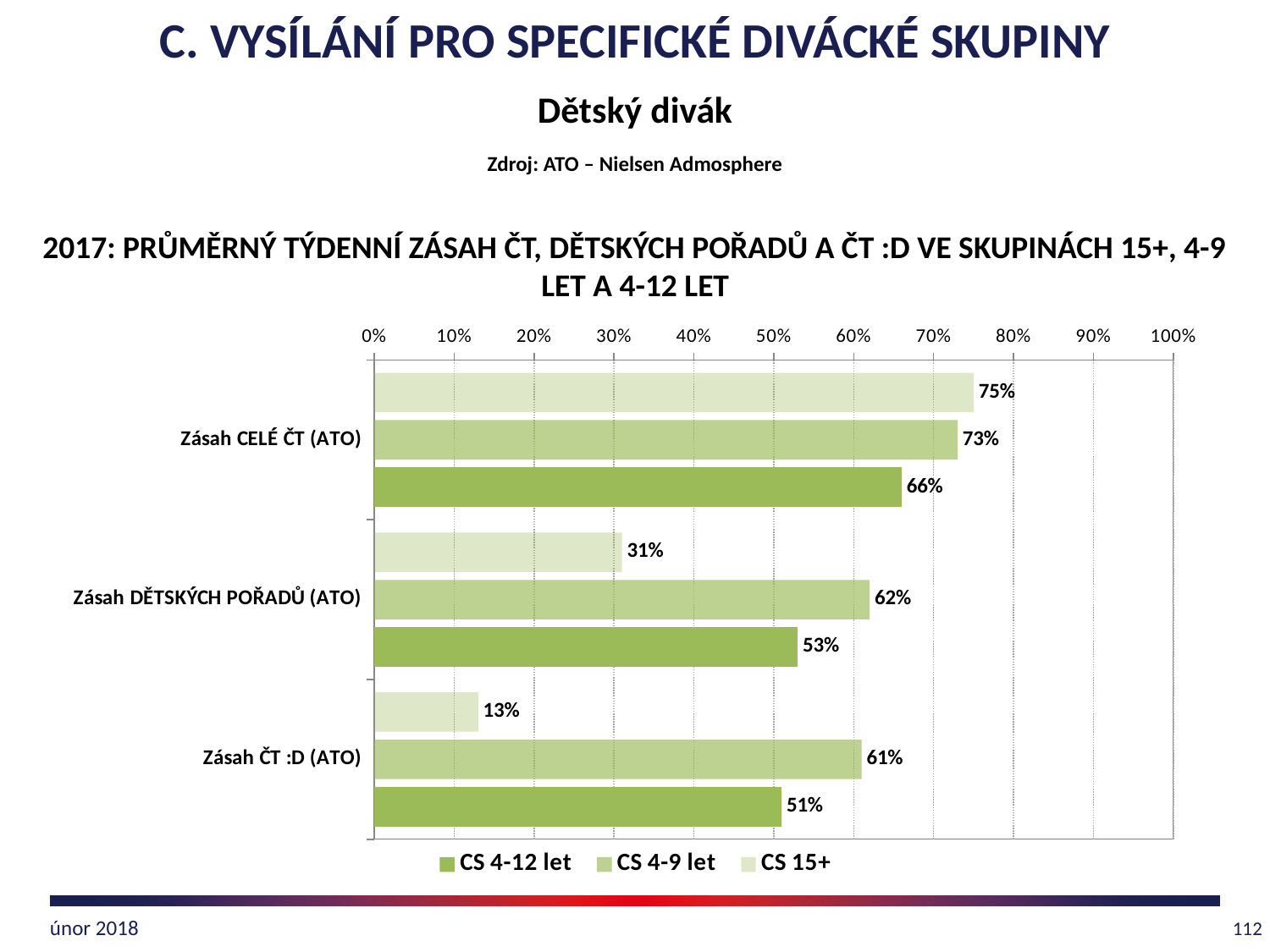
Which is larger in the Zásah ČT :D (ATO) category: the CS 4-9 let value or the CS 4-12 let value? CS 4-9 let Which category has the lowest value for the CS 15+ series? Zásah ČT :D (ATO) What kind of chart is shown on the slide? Bar chart What is the value for CS 15+ in the Zásah ČT :D (ATO) category? 13% What is the difference between the CS 4-9 let and CS 15+ values in the Zásah DĚTSKÝCH POŘADŮ (ATO) category? 31% What is the value for CS 4-12 let in the Zásah ČT :D (ATO) category? 51% How many categories are shown on the chart? 3 What is the source cited for the chart data? ATO – Nielsen Admosphere Which category has the highest value for the CS 4-12 let series? Zásah CELÉ ČT (ATO) How many series does the legend list? 3 What is the value for CS 4-9 let in the Zásah DĚTSKÝCH POŘADŮ (ATO) category? 62% What is the value for CS 15+ in the Zásah CELÉ ČT (ATO) category? 75%